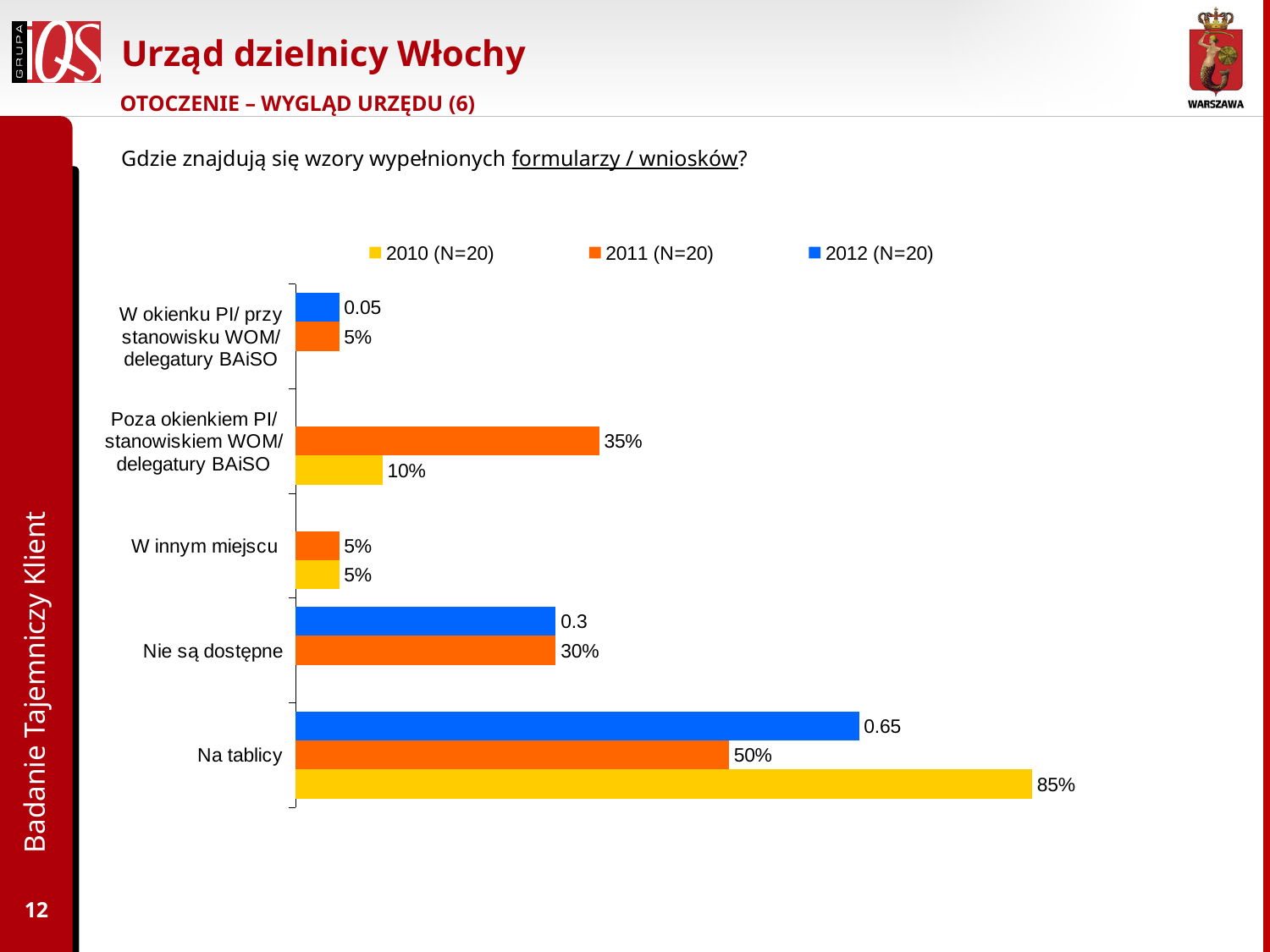
Which category has the lowest value in the 2011 (N=20) series? W okienku PI/ przy stanowisku WOM/ delegatury BAiSO and W innym miejscu (both 5%) What kind of chart is shown on the slide? bar chart What is the value for 'Poza okienkiem PI/ stanowiskiem WOM/ delegatury BAiSO' in the 2011 (N=20) series? 35% What is the value for 'Nie są dostępne' in the 2011 (N=20) series? 30% What is the value for 'Na tablicy' in the 2010 (N=20) series? 85% How many series does the legend list? 3 Which is larger for 'Poza okienkiem PI/ stanowiskiem WOM/ delegatury BAiSO': the 2010 (N=20) value or the 2011 (N=20) value? 2011 (N=20) How many categories are shown on the chart? 5 Which category has the highest value in the 2010 (N=20) series? Na tablicy What is the value for 'Na tablicy' in the 2011 (N=20) series? 50% What is the difference between the 2010 (N=20) and 2011 (N=20) values for 'Na tablicy'? 35 percentage points What is the value for 'Na tablicy' in the 2012 (N=20) series? 0.65